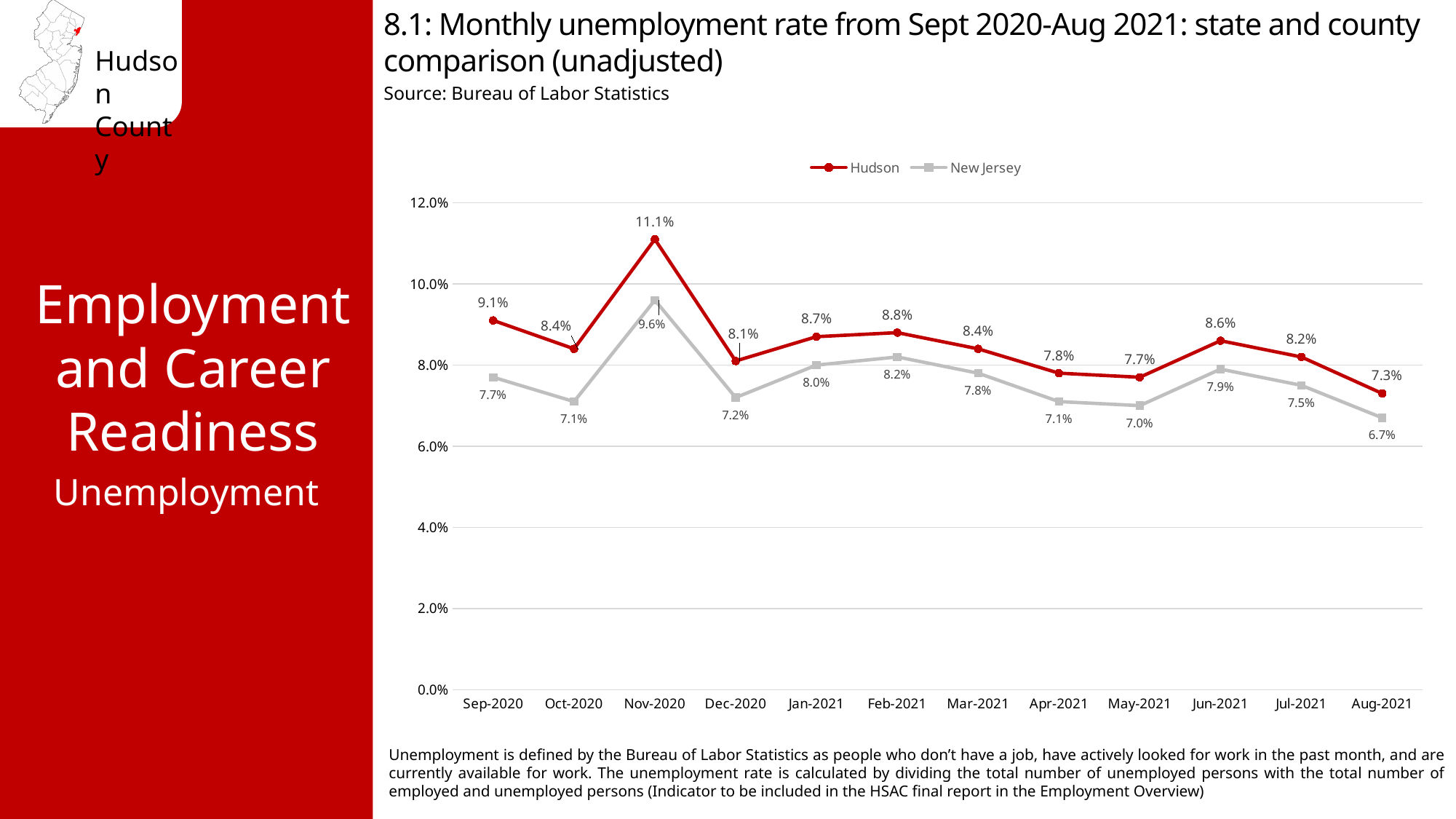
What was the New Jersey unemployment rate in Aug-2021? 6.7% In which month did New Jersey have its lowest unemployment rate? Aug-2021 What kind of chart is shown on the slide? Line chart Which had the higher unemployment rate in Jun-2021, Hudson or New Jersey? Hudson What was the Hudson unemployment rate in Feb-2021? 8.8% Did the Hudson unemployment rate rise or fall from Jun-2021 to Aug-2021? Fall In which month did Hudson have its highest unemployment rate? Nov-2020 What colour is the Hudson line in the chart? Red How many months are plotted on the x axis? 12 What is the difference between the Hudson and New Jersey unemployment rates in Nov-2020? 1.5% What was the Hudson unemployment rate in Nov-2020? 11.1% How many series does the legend list? 2